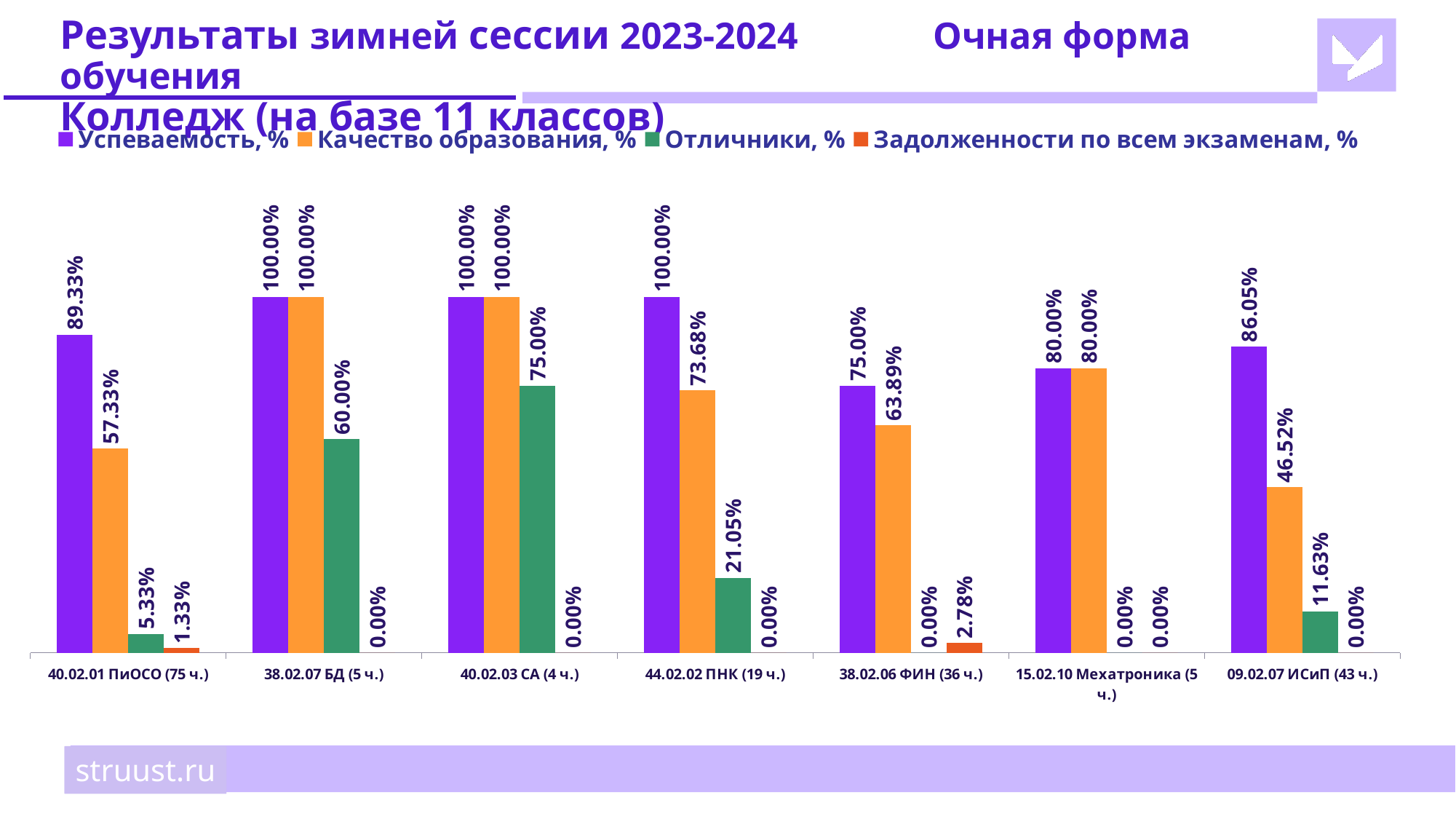
Which is larger: Качество образования, % for 44.02.02 ПНК (19 ч.) or for 38.02.06 ФИН (36 ч.)? 44.02.02 ПНК (19 ч.) Which series is shown in orange in the legend? Качество образования, % Which category has the highest value for Отличники, %? 40.02.03 СА (4 ч.) What is the value of Задолженности по всем экзаменам, % for 38.02.06 ФИН (36 ч.)? 2.78% Which category has the lowest value for Успеваемость, %? 38.02.06 ФИН (36 ч.) How many series does the legend list? 4 What is the value of Отличники, % for 44.02.02 ПНК (19 ч.)? 21.05% What is the value of Качество образования, % for 40.02.01 ПиОСО (75 ч.)? 57.33% What kind of chart is shown on the slide? Bar chart How many categories are shown on the x axis? 7 What is the value of Успеваемость, % for 09.02.07 ИСиП (43 ч.)? 86.05% What is the difference between Успеваемость, % and Качество образования, % for 09.02.07 ИСиП (43 ч.)? 39.53%